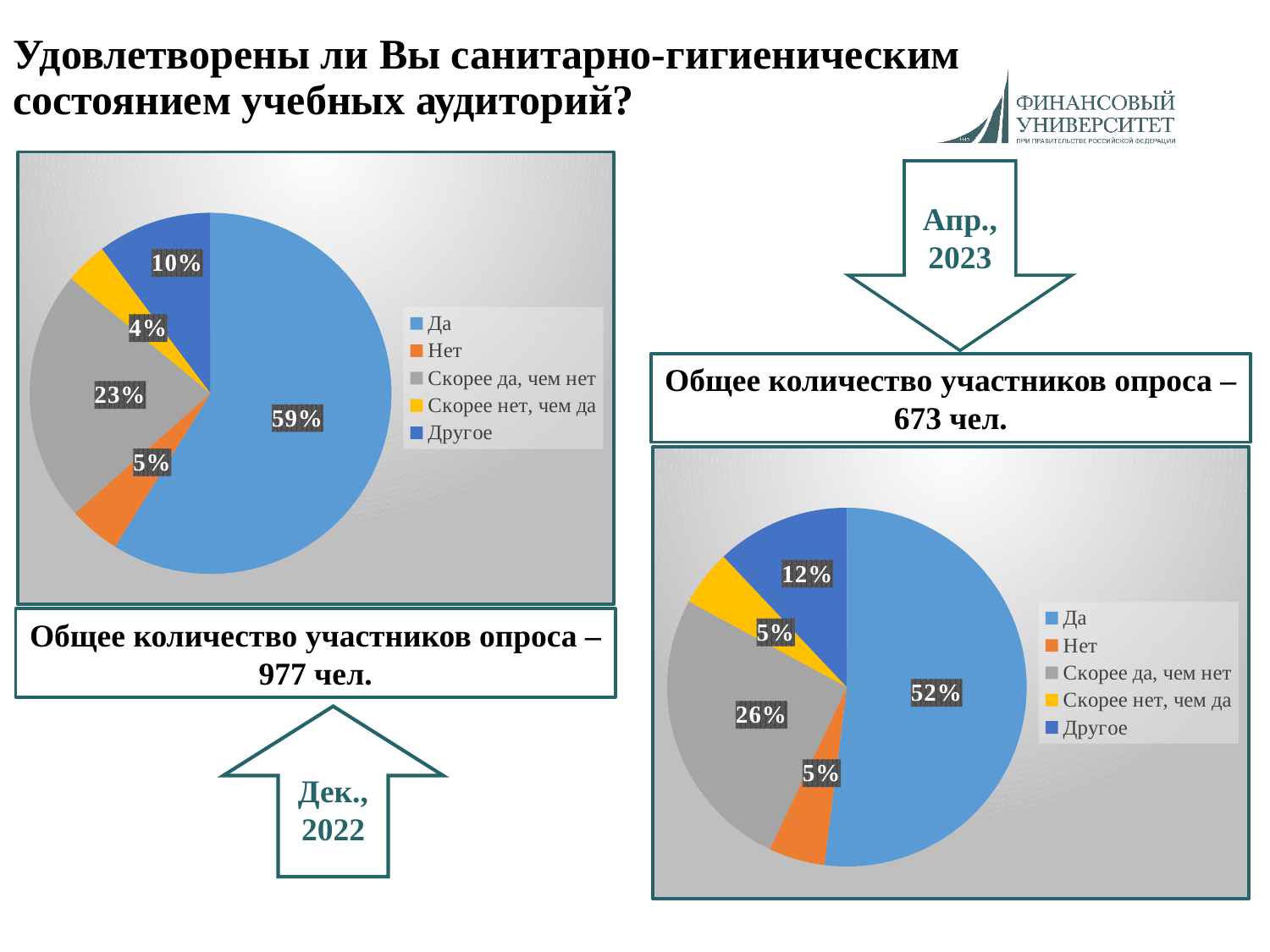
What colour represents "Скорее нет, чем да" in the legend of the right pie chart? Yellow In the right pie chart (Апр., 2023), what is the difference between the "Да" share and the "Скорее да, чем нет" share? 26% In the left pie chart (Dec., 2022), which is larger: the "Другое" slice or the "Нет" slice? Другое In the left pie chart (Dec., 2022), what share is labelled for "Скорее да, чем нет"? 23% In the right pie chart (Апр., 2023), which category has the largest slice? Да In the right pie chart (Апр., 2023), what share of respondents answered "Да"? 52% In the left pie chart (Dec., 2022), which category has the smallest slice? Скорее нет, чем да In the right pie chart (Апр., 2023), what share is labelled for "Другое"? 12% In the left pie chart (Dec., 2022), what share of respondents answered "Да"? 59% How many categories does the legend of the left pie chart list? 5 According to the text box under the left pie chart, how many participants took part in the Dec., 2022 survey? 977 чел. What type of chart is used on the right side of the slide (Апр., 2023)? Pie chart